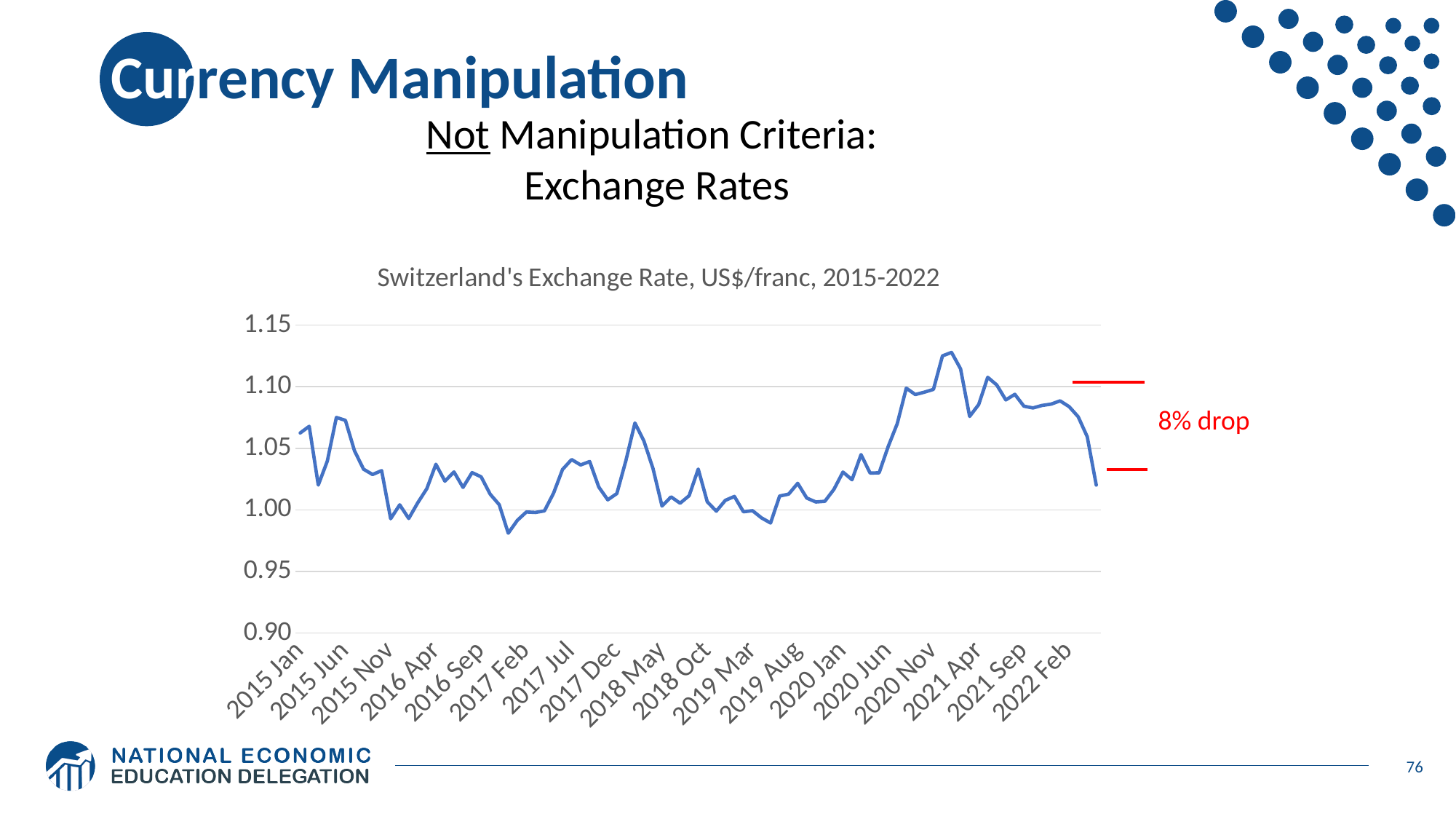
How many date labels are shown on the x axis? 18 Is the value for 2016 Apr greater or less than 1.00? greater What kind of chart is shown on the slide? Line chart Is the value for 2015 Jan greater or less than 1.05? greater Is the value for 2022 Feb greater or less than 1.05? greater What does the red annotation to the right of the line say? 8% drop What is the title of the chart? Switzerland's Exchange Rate, US$/franc, 2015-2022 Does the exchange rate rise or fall between 2019 Aug and 2020 Nov? rise